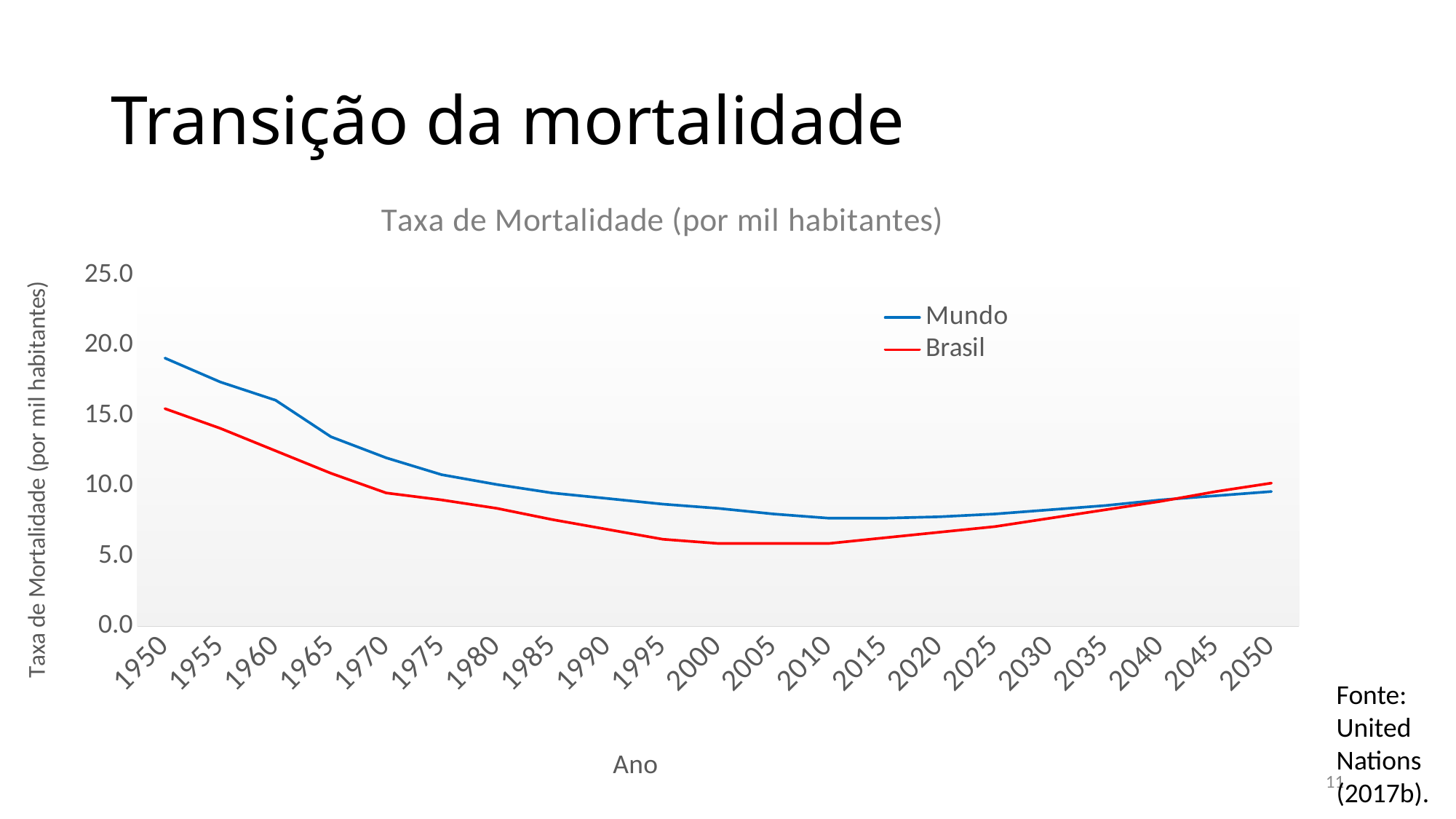
How many years are marked along the x axis? 21 Is the value for Mundo in 1950 greater or less than 15.0? greater What is the title of the chart? Taxa de Mortalidade (por mil habitantes) Which colour is used for the Brasil line? red Does the Mundo line rise or fall between 1950 and 2010? fall In 2000, which series has the higher value, Mundo or Brasil? Mundo In 1950, which series has the higher value, Mundo or Brasil? Mundo Is the value for Brasil in 2000 greater or less than 10.0? less Is the value for Mundo in 1965 greater or less than 15.0? less How many series does the legend list? 2 What kind of chart is shown on the slide? line chart